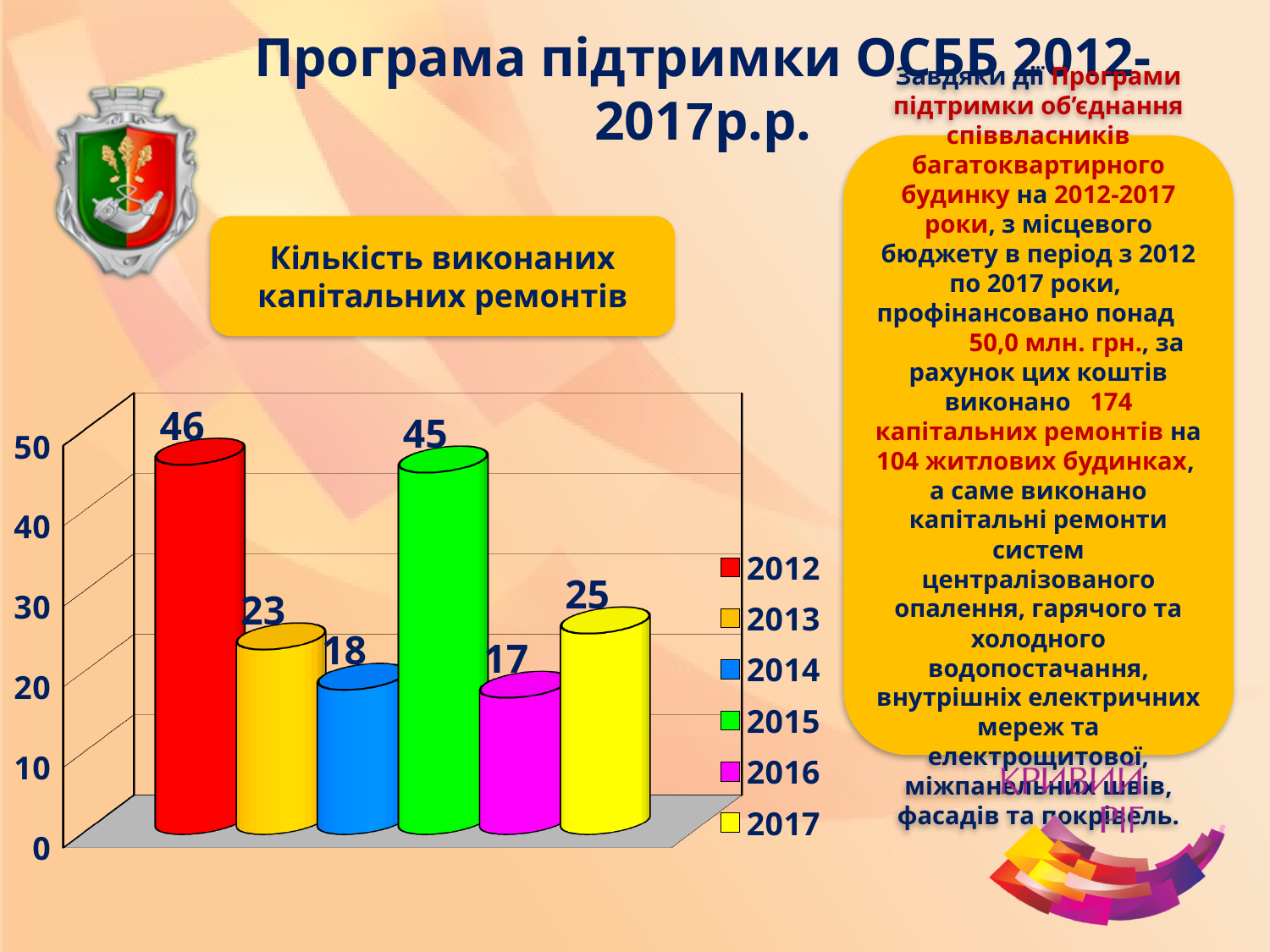
What is the difference between the values for 2012 and 2013? 23 What is the difference between the values for 2017 and 2014? 7 Which is larger, the value for 2013 or the value for 2017? 2017 What is the value for 2017? 25 What is the value for 2012? 46 What is the value for 2016? 17 Is the value for 2014 greater or less than 20? less What kind of chart is shown on the slide? bar chart How many entries does the legend list? 6 How many bars are plotted in the chart? 6 Which year has the lowest value? 2016 What is the value for 2015? 45